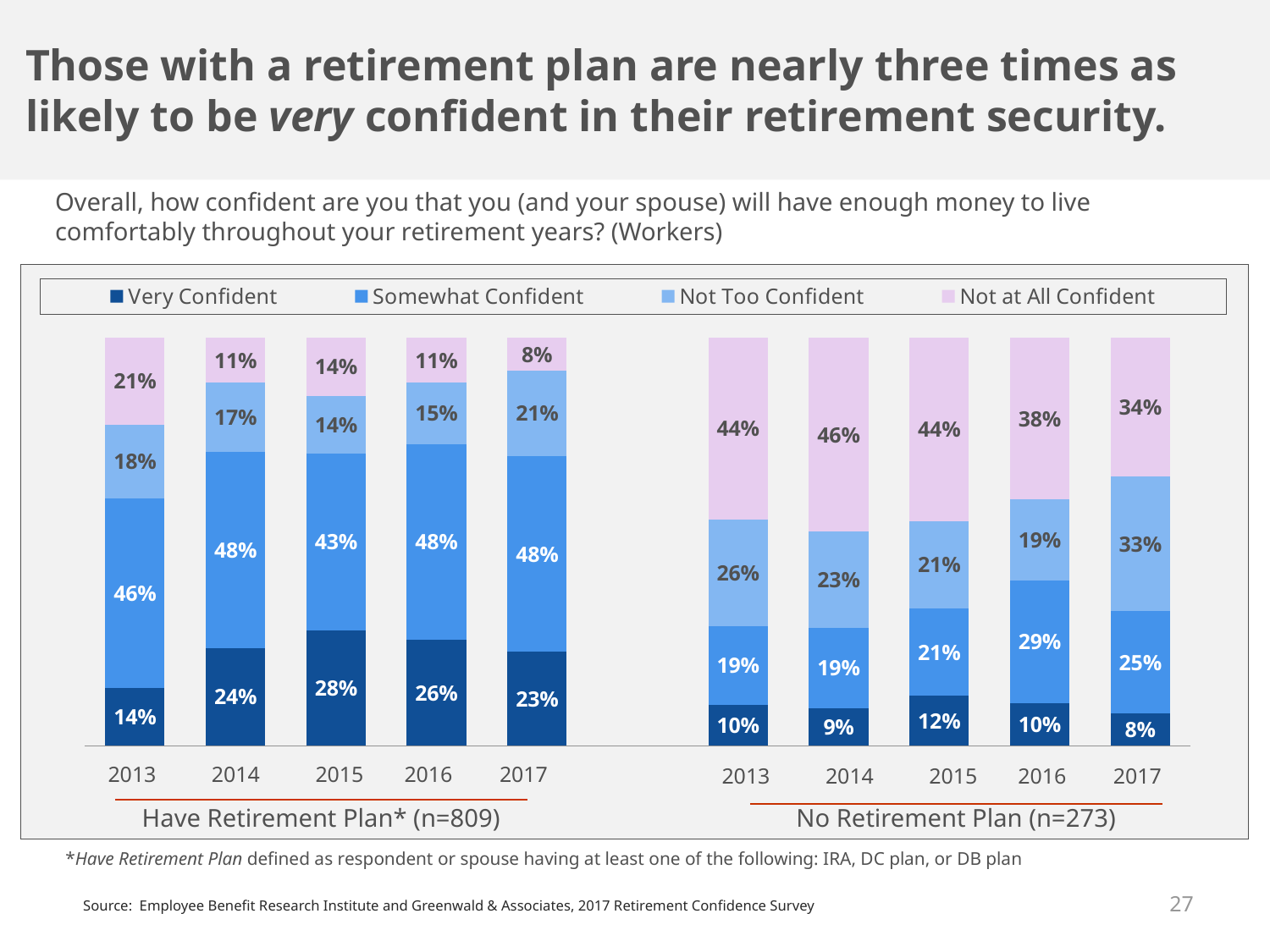
What percentage of workers with a retirement plan were somewhat confident in 2015? 43% What is the difference between the very confident share for workers with a retirement plan and those with no retirement plan in 2017? 15 percentage points What is the combined share of very confident and somewhat confident workers with no retirement plan in 2016? 39% How many series does the legend list? 4 How many years are shown for the No Retirement Plan group? 5 In 2016, which group had a larger not too confident share: workers with a retirement plan or workers with no retirement plan? No Retirement Plan What kind of chart is shown on the slide? Stacked bar chart In which year was the very confident share highest among workers with a retirement plan? 2015 What percentage of workers with no retirement plan were not at all confident in 2014? 46% In which year was the not at all confident share lowest among workers with a retirement plan? 2017 What is the sample size (n) for the Have Retirement Plan group? 809 What percentage of workers with a retirement plan were very confident in 2017? 23%